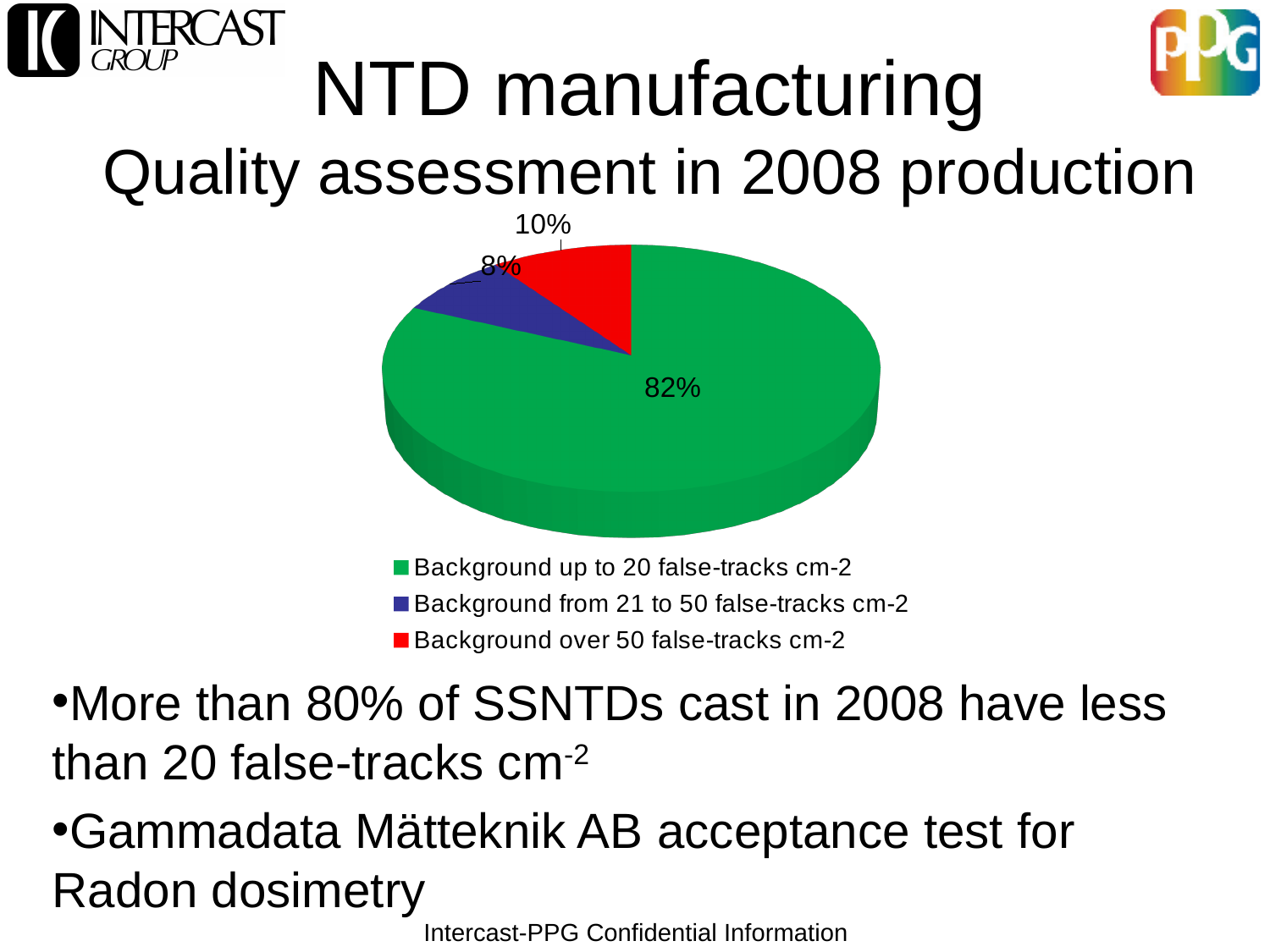
What colour is the slice for 'Background up to 20 false-tracks cm-2'? Green How many entries does the legend list? 3 What share of the pie is labelled for 'Background up to 20 false-tracks cm-2'? 82% Which category has the smallest slice of the pie? Background from 21 to 50 false-tracks cm-2 What kind of chart is shown on the slide? Pie chart What share of the pie is labelled for 'Background from 21 to 50 false-tracks cm-2'? 8% Which category has the largest slice of the pie? Background up to 20 false-tracks cm-2 Which slice is larger: 'Background over 50 false-tracks cm-2' or 'Background from 21 to 50 false-tracks cm-2'? Background over 50 false-tracks cm-2 What colour is the slice for 'Background over 50 false-tracks cm-2'? Red How many slices does the pie chart have? 3 What is the difference in percentage points between the 'Background up to 20 false-tracks cm-2' slice and the 'Background over 50 false-tracks cm-2' slice? 72 What share of the pie is labelled for 'Background over 50 false-tracks cm-2'? 10%